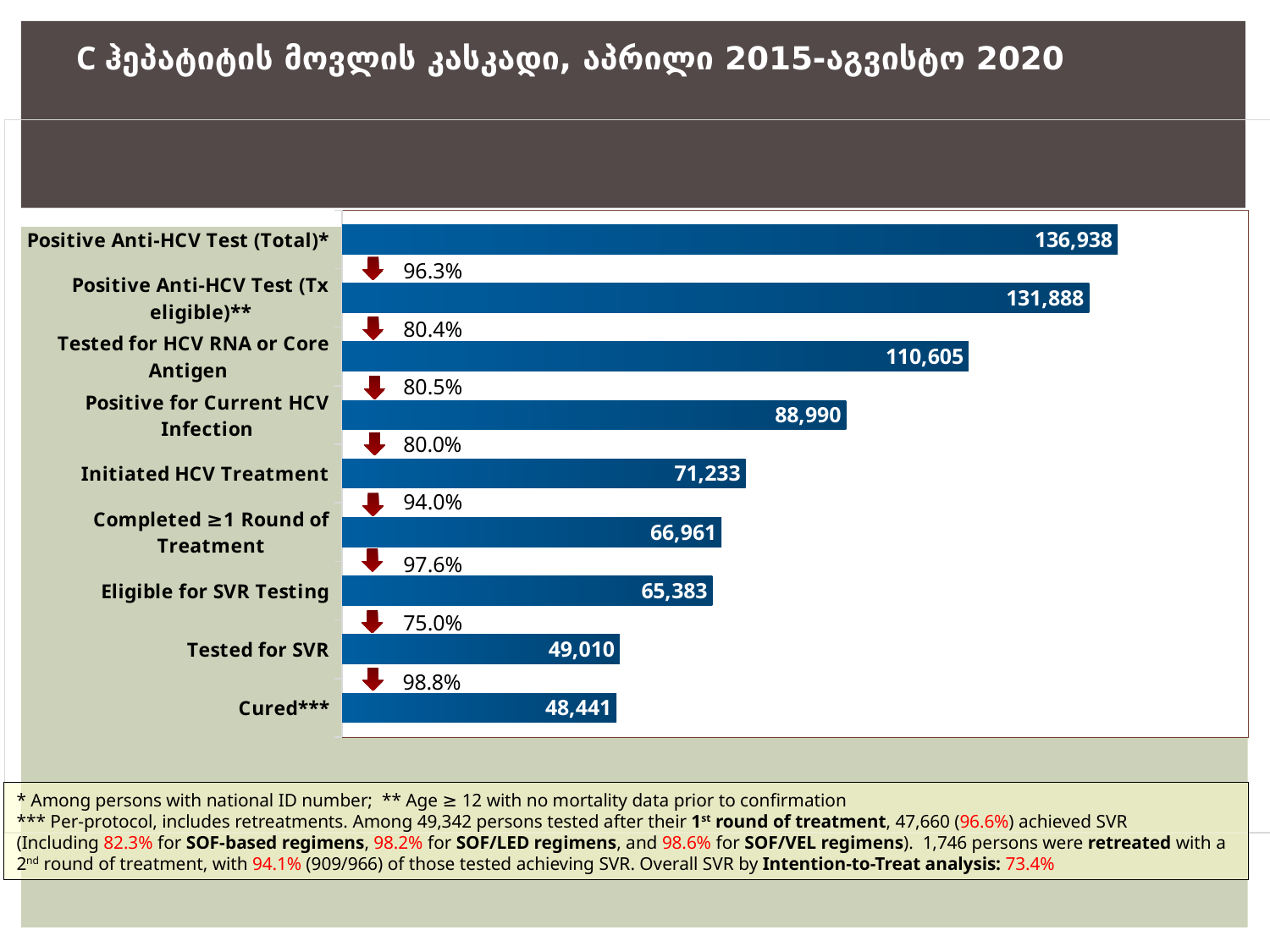
What kind of chart is shown on the slide? Bar chart What is the value for Initiated HCV Treatment? 71,233 What percentage is shown between Eligible for SVR Testing and Tested for SVR? 75.0% What is the difference between Tested for SVR and Cured***? 569 What is the value for Tested for HCV RNA or Core Antigen? 110,605 Which is larger, Completed ≥1 Round of Treatment or Eligible for SVR Testing? Completed ≥1 Round of Treatment Which category has the lowest value? Cured*** What is the difference between Positive for Current HCV Infection and Initiated HCV Treatment? 17,757 What is the value for Cured***? 48,441 How many categories are shown in the chart? 9 What is the value for Positive Anti-HCV Test (Total)*? 136,938 Which category has the highest value? Positive Anti-HCV Test (Total)*